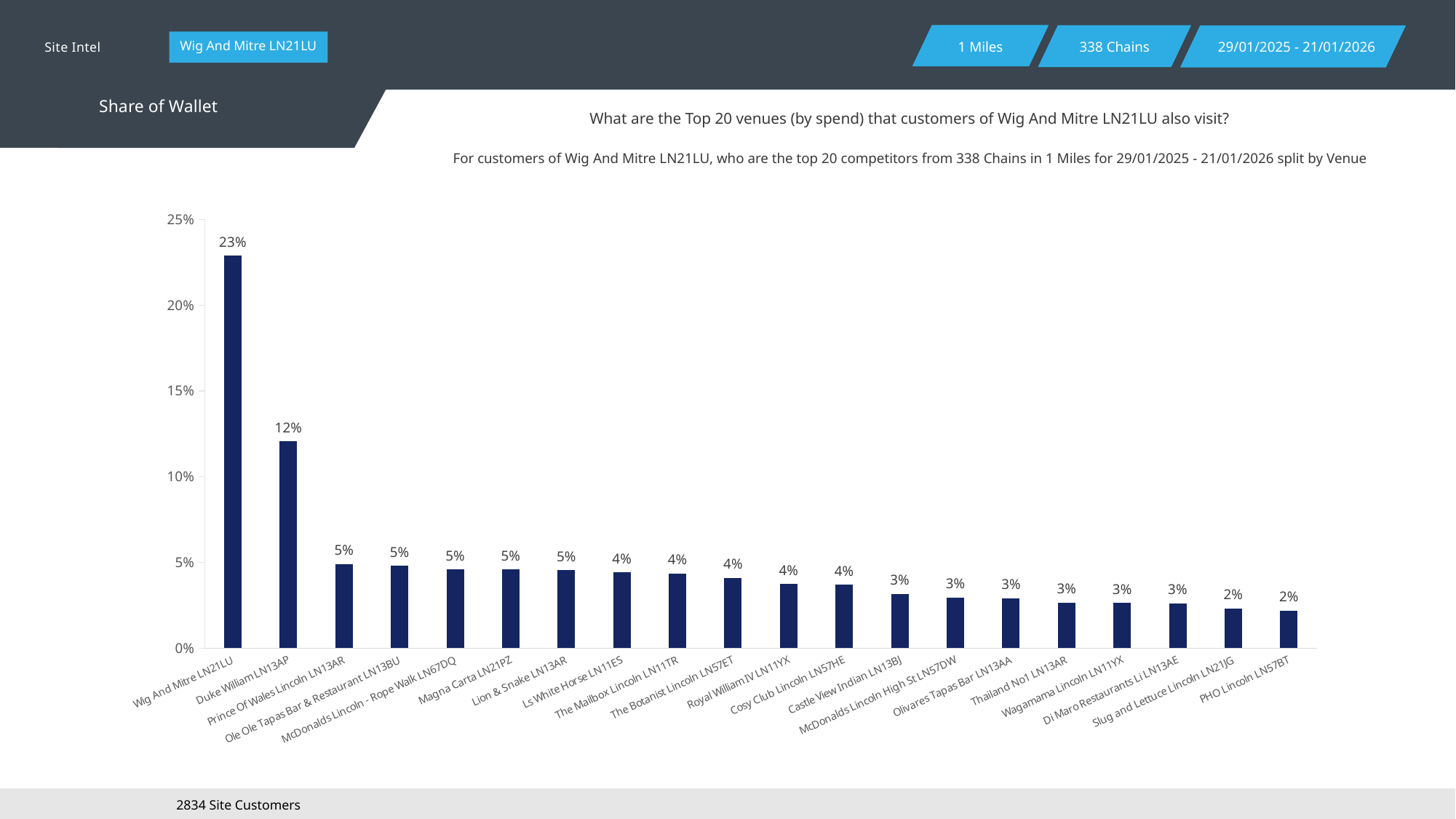
What is the value for PHO Lincoln LN57BT? 2% How many venues are shown on the chart? 20 What is the title of the chart? What are the Top 20 venues (by spend) that customers of Wig And Mitre LN21LU also visit? Which venue has the highest value? Wig And Mitre LN21LU What is the difference between the values for Wig And Mitre LN21LU and Duke William LN13AP? 11% Which is larger, the value for Duke William LN13AP or the value for Prince Of Wales Lincoln LN13AR? Duke William LN13AP What is the value for Cosy Club Lincoln LN57HE? 4% What is the value for Duke William LN13AP? 12% Is the value for Wig And Mitre LN21LU greater or less than 20%? greater What kind of chart is shown on the slide? bar chart Do the values rise or fall from left to right along the x axis? fall What is the value for Wig And Mitre LN21LU? 23%